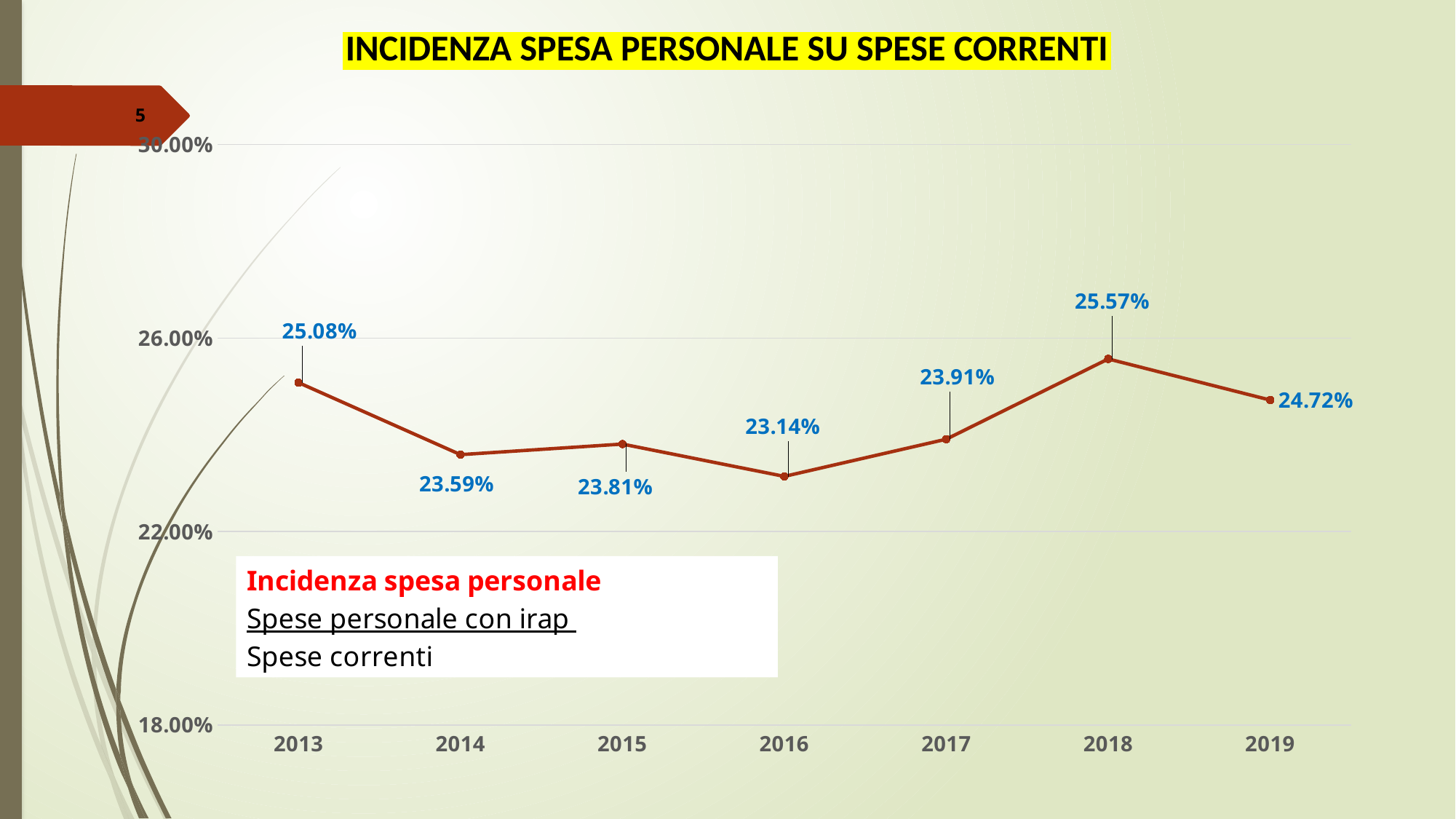
What kind of chart is shown on the slide? line chart What is the title of the chart? INCIDENZA SPESA PERSONALE SU SPESE CORRENTI What is the value for 2019? 24.72% Which is larger, the value for 2014 or the value for 2017? 2017 What is the difference between the values for 2018 and 2016? 2.43% What is the value for 2013? 25.08% Is the value for 2015 greater or less than 26.00%? less Which year has the highest value? 2018 How many years are plotted on the chart? 7 What is the value for 2016? 23.14% Do the values rise or fall from 2016 to 2018? rise Which year has the lowest value? 2016